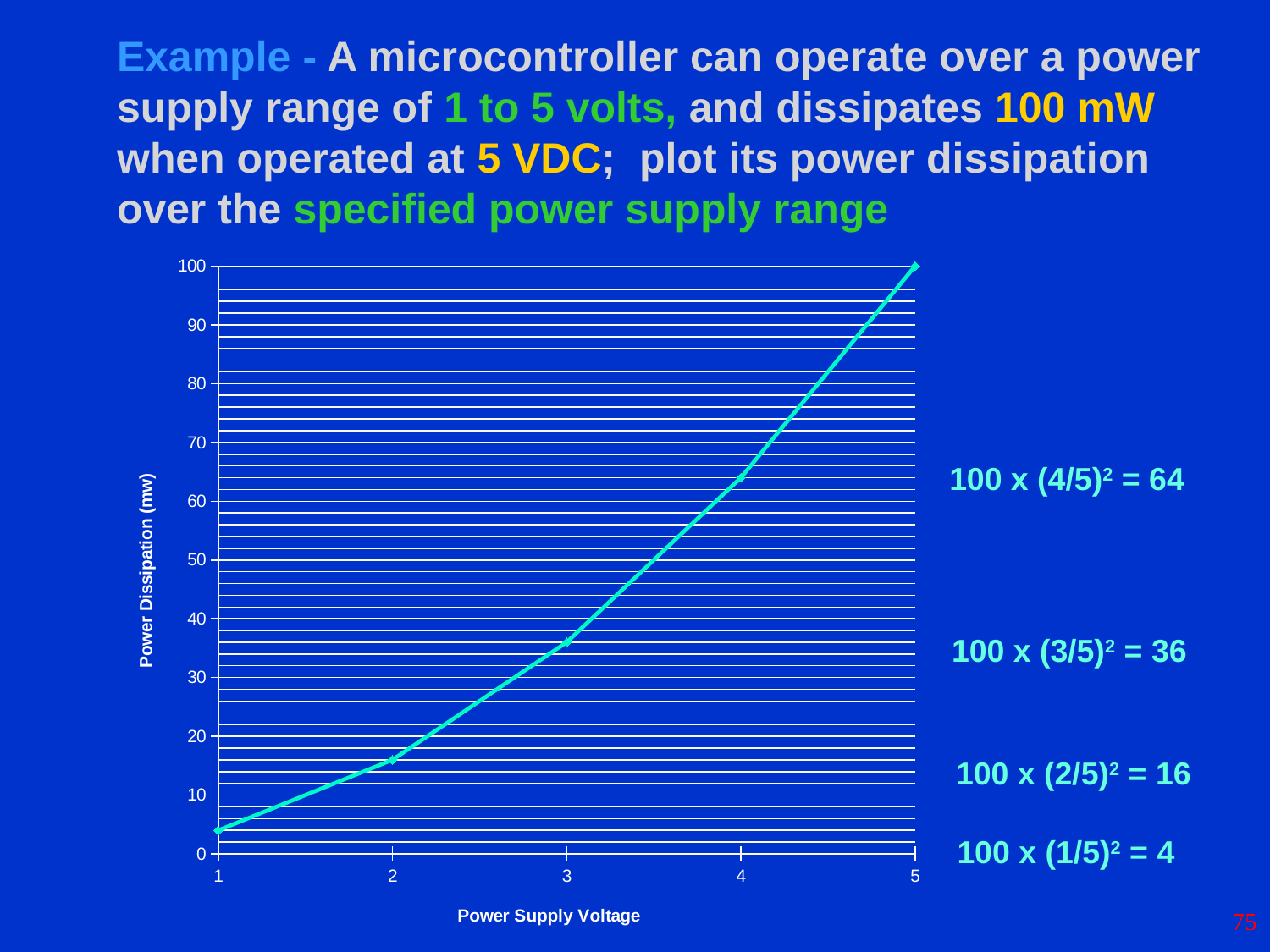
At which power supply voltage is the power dissipation lowest? 1 What is the power dissipation at a power supply voltage of 3? 36 What is the power dissipation at a power supply voltage of 1? 4 Does the power dissipation rise or fall as the power supply voltage increases from 1 to 5? rise What is the label of the y axis? Power Dissipation (mw) How many data points are plotted on the line? 5 At which power supply voltage is the power dissipation highest? 5 What is the power dissipation at a power supply voltage of 4? 64 What is the difference in power dissipation between a supply voltage of 4 and a supply voltage of 3? 28 What is the power dissipation at a power supply voltage of 2? 16 What kind of chart is shown on the slide? line chart What is the label of the x axis? Power Supply Voltage